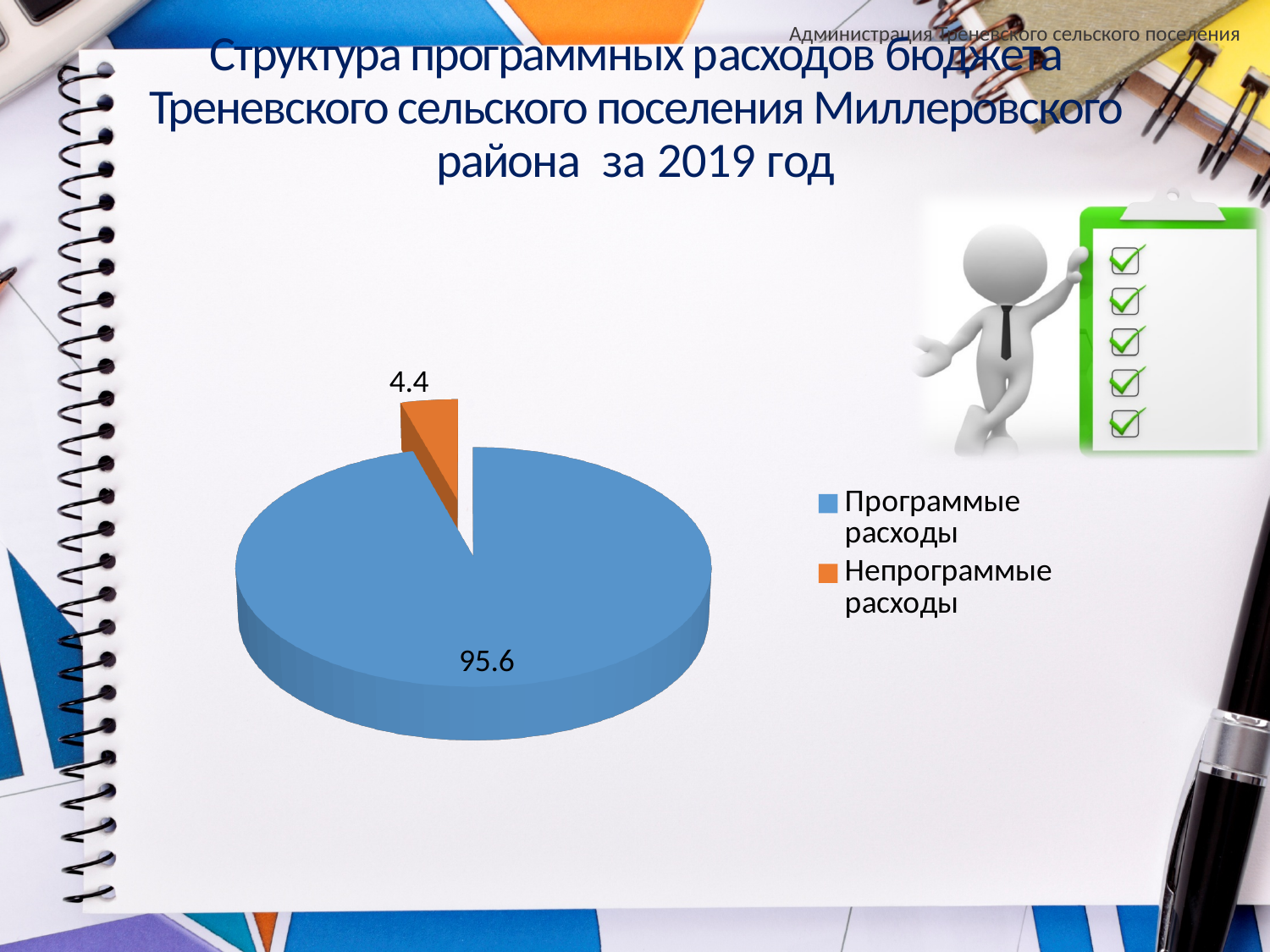
Which category has the largest slice of the pie? Программые расходы What colour is the slice for Программые расходы? blue Which is larger: Программые расходы or Непрограммые расходы? Программые расходы What is the value for Непрограммые расходы? 4.4 What is the value for Программые расходы? 95.6 Which category has the smallest slice of the pie? Непрограммые расходы What is the difference between the values for Программые расходы and Непрограммые расходы? 91.2 What type of chart is shown on the slide? pie chart What colour is the slice for Непрограммые расходы? orange How many entries does the legend list? 2 How many categories does the pie chart show? 2